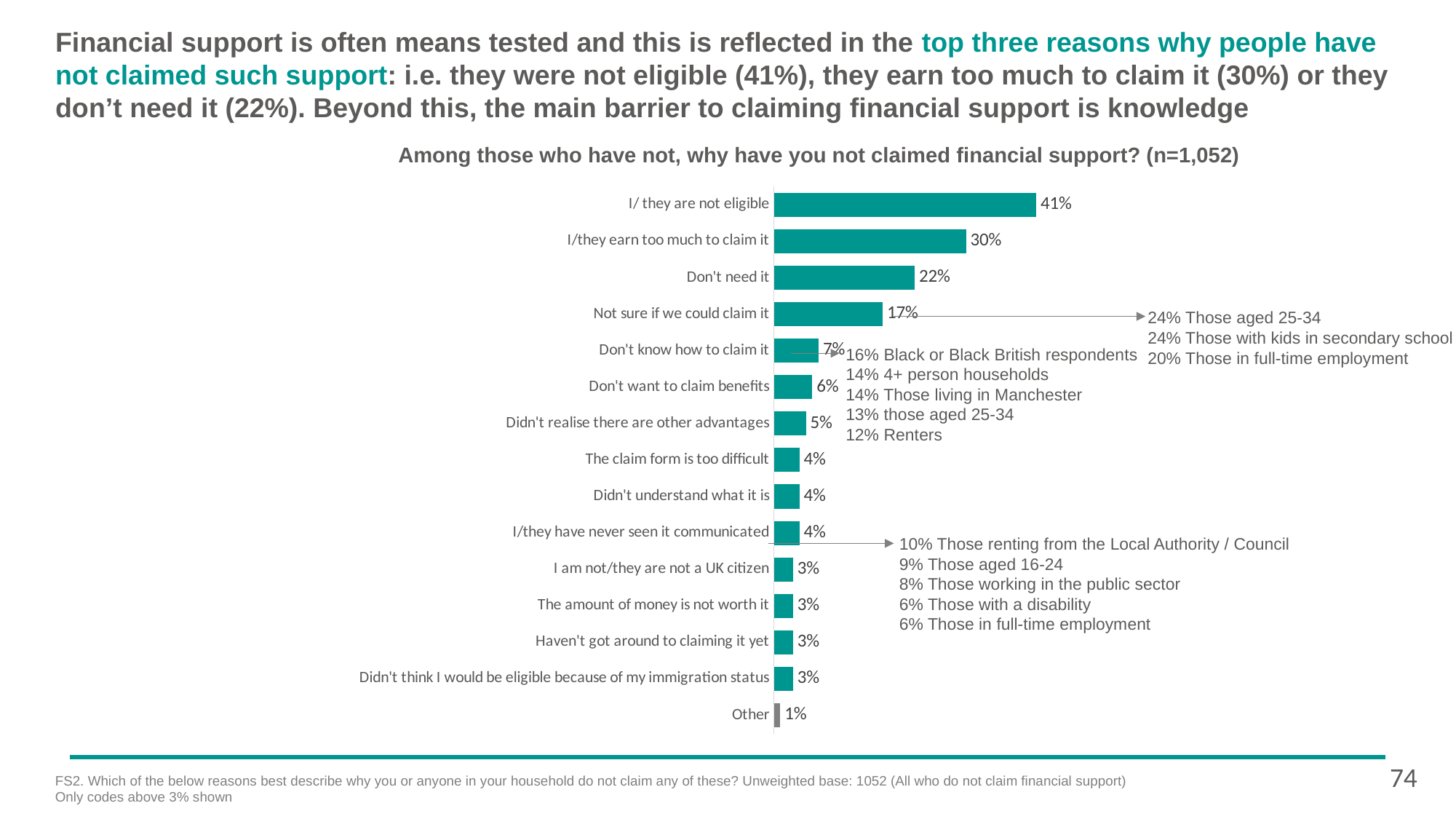
Which category has the lowest value on the chart? Other What percentage said 'Don't know how to claim it'? 7% What is the value for 'The claim form is too difficult'? 4% What is the value for 'Not sure if we could claim it'? 17% Which is larger: 'Don't want to claim benefits' or 'Didn't realise there are other advantages'? Don't want to claim benefits Which reason has the highest percentage? I/ they are not eligible What is the difference between 'I/they earn too much to claim it' and 'Don't need it'? 8% What is the sample size (n) given in the chart title? 1,052 What type of chart is shown on the slide? Bar chart What percentage of respondents said they are not eligible? 41% What is the difference between 'I/ they are not eligible' and 'Not sure if we could claim it'? 24% How many categories are shown on the chart? 15